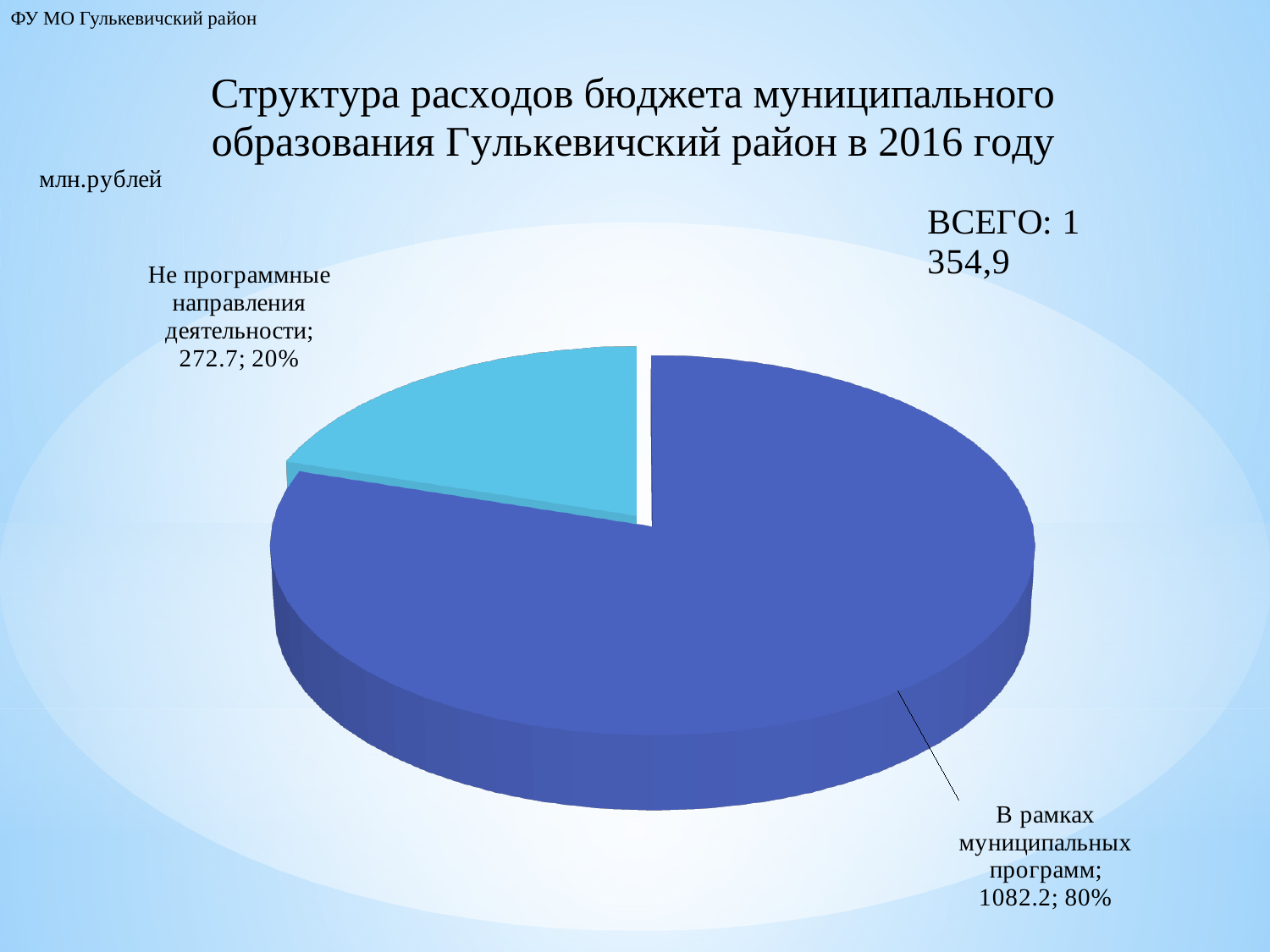
What unit of measurement is indicated on the slide? млн.рублей What share of the pie does 'Не программные направления деятельности' represent? 20% Which is larger: 'В рамках муниципальных программ' or 'Не программные направления деятельности'? В рамках муниципальных программ Which category has the largest slice? В рамках муниципальных программ What is the value for 'В рамках муниципальных программ'? 1082.2 What is the difference between the values for 'В рамках муниципальных программ' and 'Не программные направления деятельности'? 809.5 What is the value for 'Не программные направления деятельности'? 272.7 What kind of chart is shown on the slide? pie chart What total (ВСЕГО) is shown on the slide? 1 354,9 Which category has the smallest slice? Не программные направления деятельности What share of the pie does 'В рамках муниципальных программ' represent? 80% How many slices does the pie chart have? 2